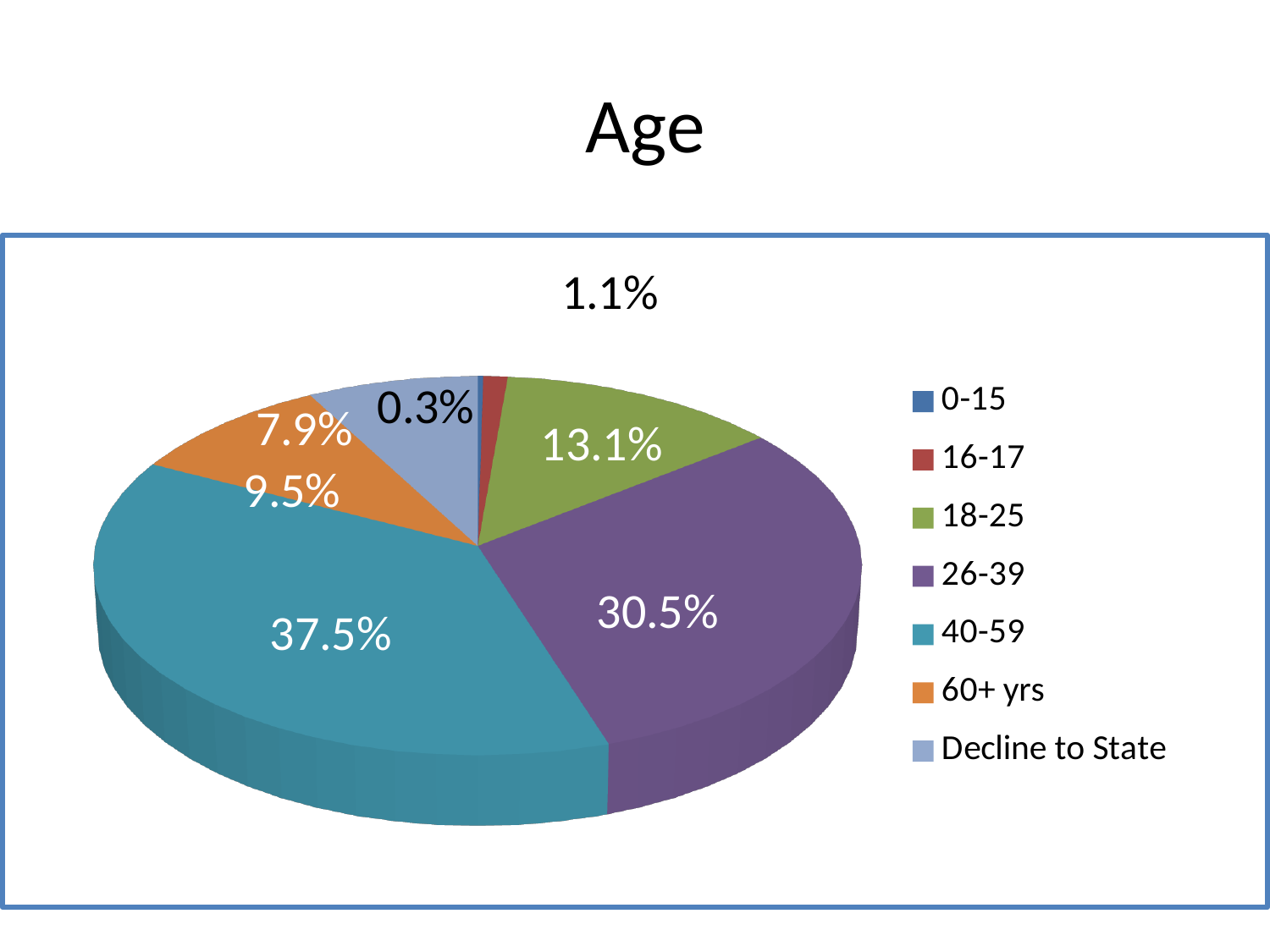
What is the title of the chart? Age Which age group has the largest share of the pie? 40-59 What percentage of respondents chose Decline to State? 7.9% What percentage of respondents are 60+ yrs? 9.5% Which age group has the smallest share of the pie? 0-15 Which is larger, the share for 60+ yrs or the share for Decline to State? 60+ yrs What type of chart is shown on the slide? pie chart What percentage of respondents are aged 18-25? 13.1% What percentage of respondents are aged 26-39? 30.5% What is the difference between the 40-59 share and the 26-39 share? 7.0% How many categories does the legend list? 7 What percentage of respondents are aged 40-59? 37.5%